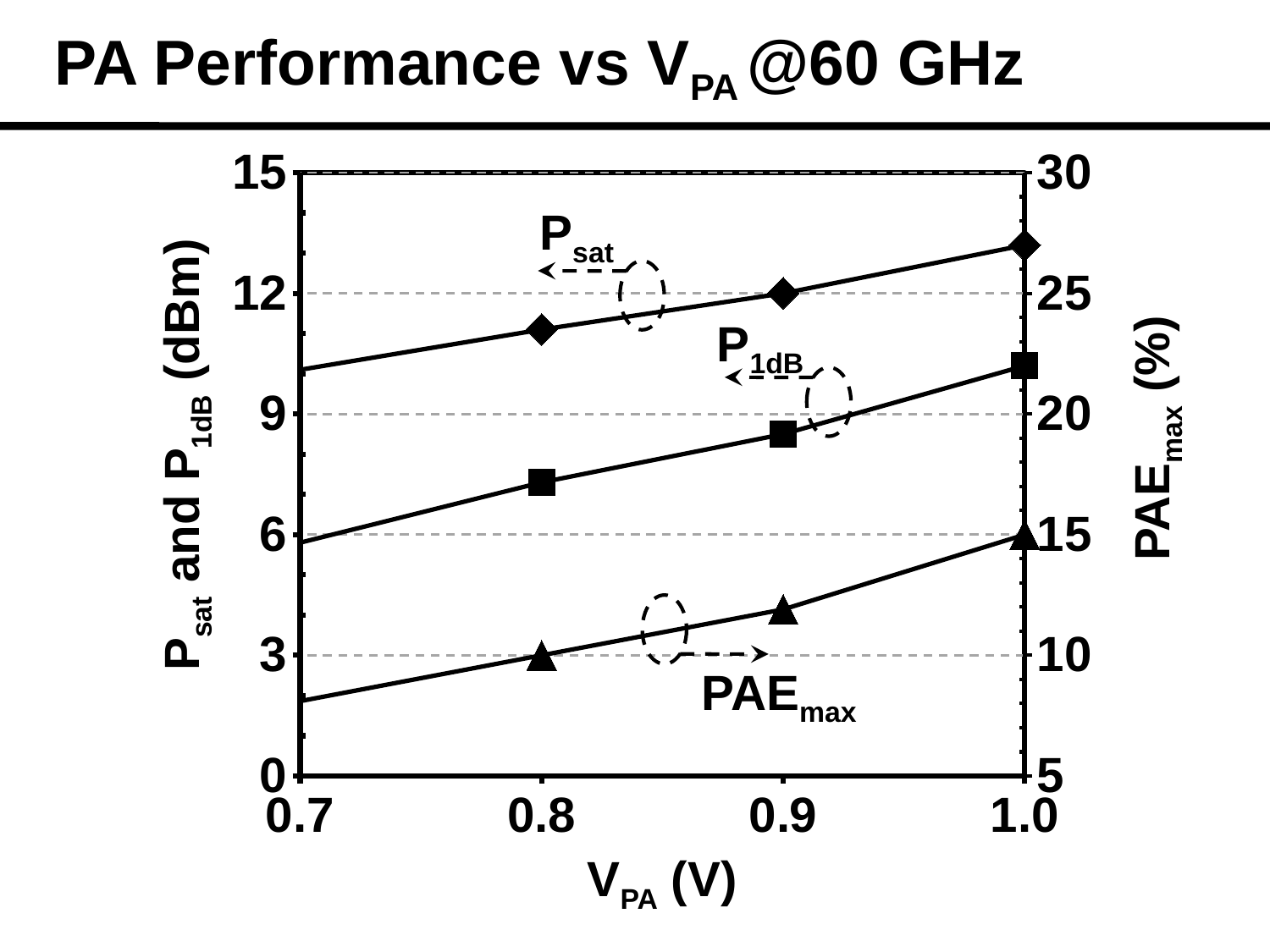
Is the value of Psat at VPA = 1.0 V greater or less than 12 dBm? greater At VPA = 0.9 V, which is larger, Psat or P1dB? Psat By how much does PAEmax increase from VPA = 0.8 V to VPA = 1.0 V? 5% What is the label of the right-hand y axis? PAEmax (%) What is the value of Psat at VPA = 0.9 V? 12 dBm What kind of chart is shown on the slide? line chart Does Psat rise or fall as VPA increases from 0.7 V to 1.0 V? rise Is the value of P1dB at VPA = 0.8 V greater or less than 9 dBm? less What is the value of PAEmax at VPA = 1.0 V? 15% How many data series are plotted on the chart? 3 At which VPA value is P1dB highest? 1.0 V What is the value of PAEmax at VPA = 0.8 V? 10%